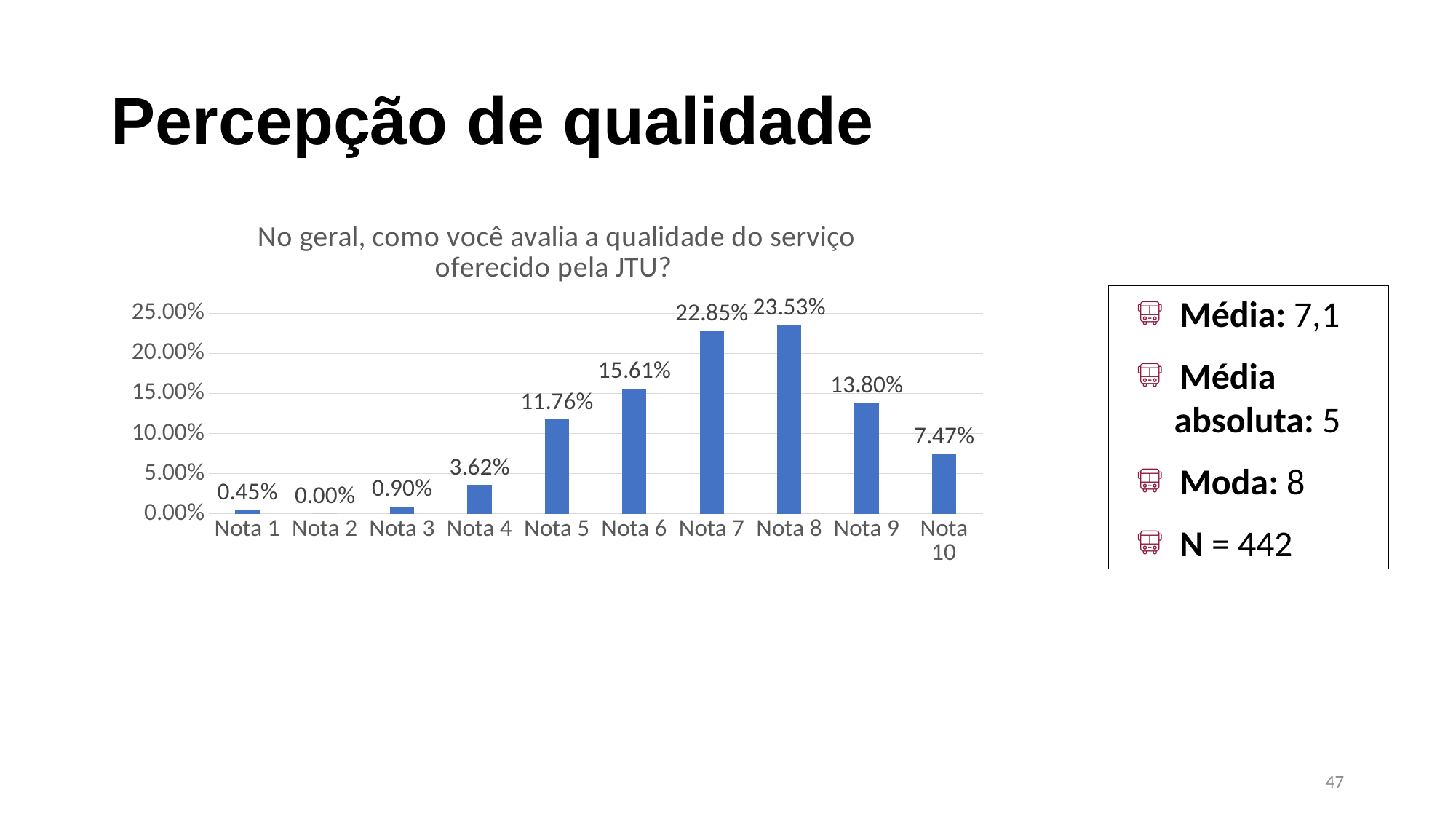
What is the difference between the values for Nota 8 and Nota 7? 0.68% What kind of chart is shown on the slide? bar chart What is the difference between the values for Nota 6 and Nota 9? 1.81% Which category has the highest value? Nota 8 What is the value for Nota 8? 23.53% Which is larger, the value for Nota 6 or the value for Nota 9? Nota 6 Is the value for Nota 7 greater or less than 20.00%? greater What is the value for Nota 5? 11.76% How many categories are shown on the x axis? 10 Which category has the lowest value? Nota 2 What is the value for Nota 10? 7.47% What is the title of the chart? No geral, como você avalia a qualidade do serviço oferecido pela JTU?